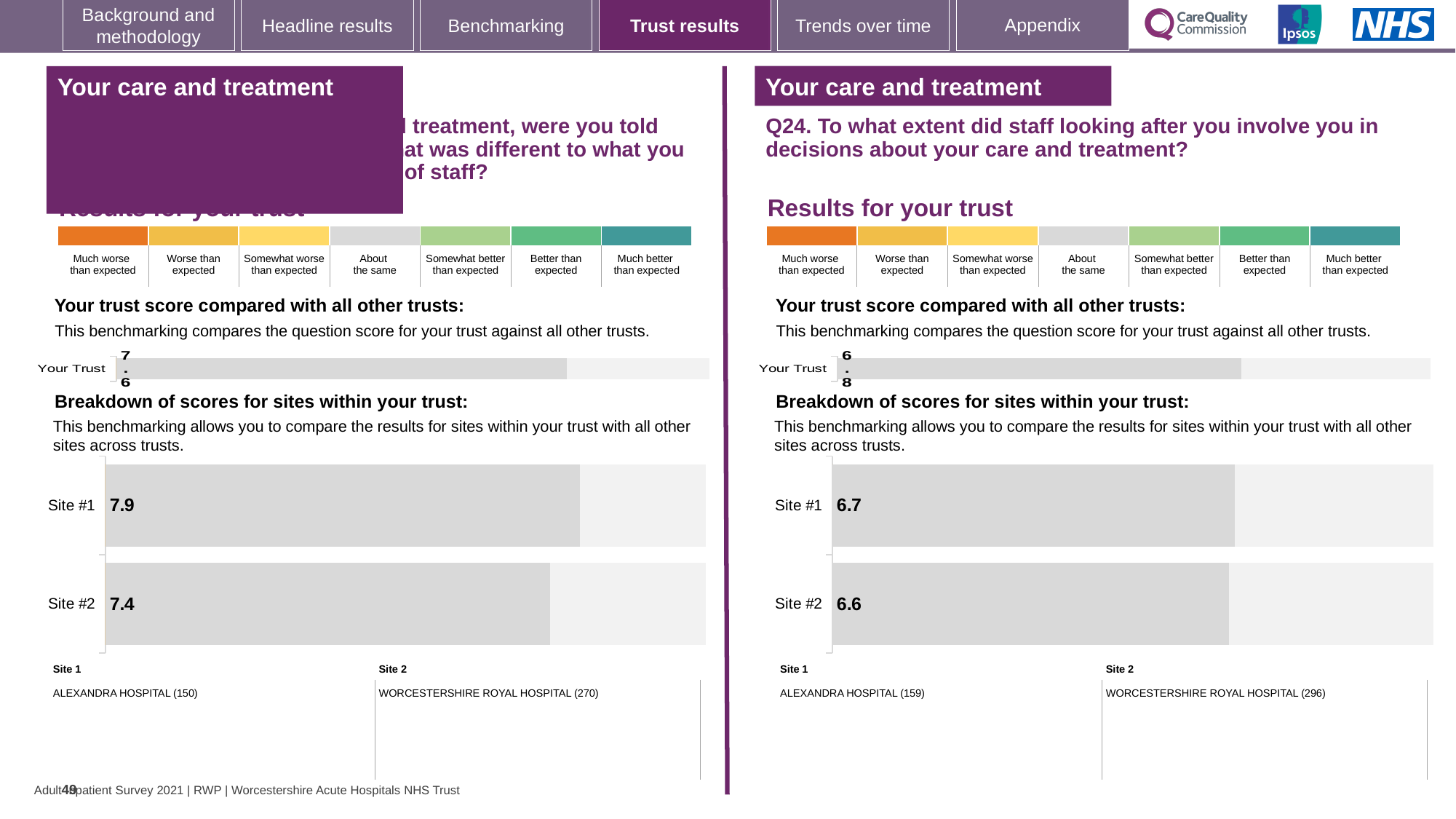
On the left-hand site breakdown chart, which site has the higher score? Site #1 On the right-hand (Q24) 'Your Trust' chart, what is the trust score? 6.8 What type of chart is used for the site breakdown on the left-hand side of the slide? Bar chart How many sites are shown on the right-hand (Q24) site breakdown chart? 2 On the left-hand 'Your Trust' chart, what is the trust score? 7.6 On the right-hand (Q24) site breakdown chart, what is the score for Site #2? 6.6 On the right-hand (Q24) site breakdown chart, which hospital is Site 2? WORCESTERSHIRE ROYAL HOSPITAL (296) On the left-hand site breakdown chart, what is the score for Site #2? 7.4 On the right-hand (Q24) site breakdown chart, what is the score for Site #1? 6.7 On the left-hand site breakdown chart, what is the difference between the Site #1 and Site #2 scores? 0.5 On the left-hand site breakdown chart, what is the score for Site #1? 7.9 On the right-hand (Q24) site breakdown chart, what is the difference between the Site #1 and Site #2 scores? 0.1